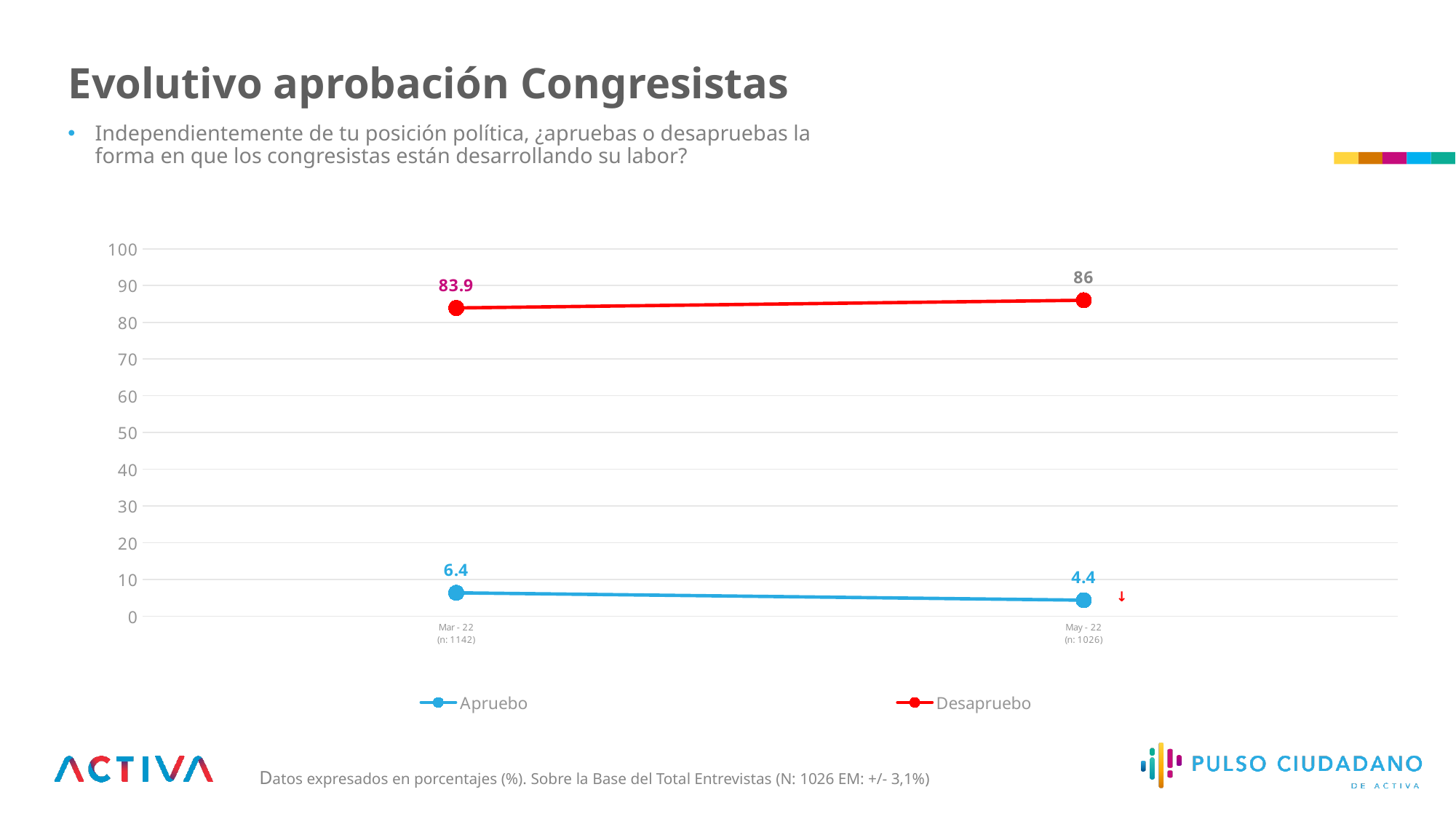
Does the Desapruebo series rise or fall from Mar - 22 to May - 22? Rise By how much did Desapruebo change from Mar - 22 to May - 22? 2.1 What is the value for Apruebo in Mar - 22? 6.4 How many series does the legend list? 2 Does the Apruebo series rise or fall from Mar - 22 to May - 22? Fall What is the value for Apruebo in May - 22? 4.4 How many time points are plotted on the x axis? 2 What is the value for Desapruebo in May - 22? 86 What type of chart is shown on the slide? Line chart Which series has the higher value in May - 22, Apruebo or Desapruebo? Desapruebo By how much did Apruebo change from Mar - 22 to May - 22? 2 What is the value for Desapruebo in Mar - 22? 83.9